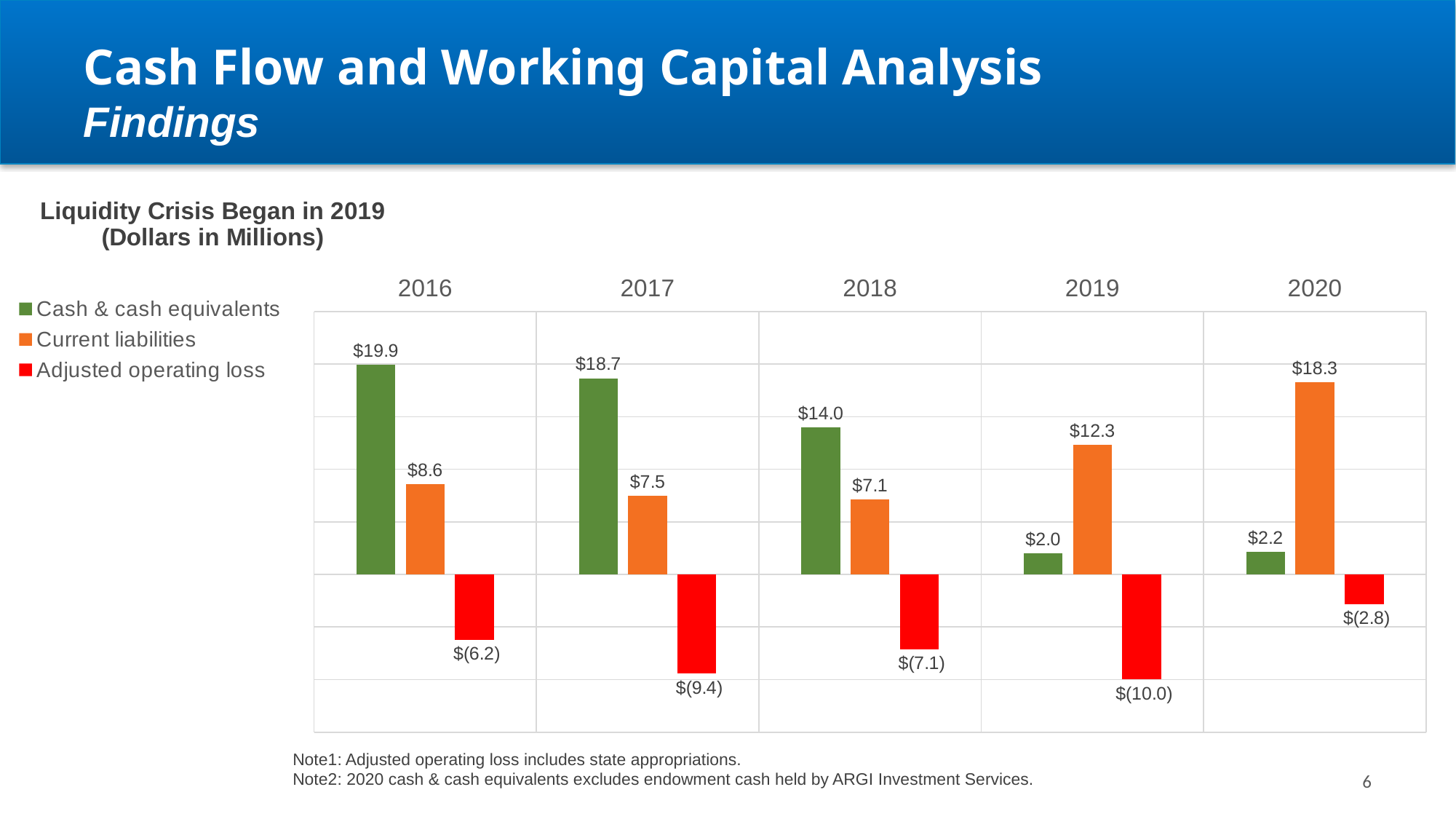
Which year has the lowest Cash & cash equivalents? 2019 How many series does the legend list? 3 Does Cash & cash equivalents rise or fall from 2016 to 2019? Fall What colour represents Adjusted operating loss in the chart? Red What is the value of Current liabilities in 2020? $18.3 What is the Adjusted operating loss in 2019? $(10.0) How many years are shown on the chart? 5 In 2019, which is larger: Cash & cash equivalents or Current liabilities? Current liabilities What is the difference between Cash & cash equivalents and Current liabilities in 2018? $6.9 Which year has the highest Current liabilities? 2020 What is the value of Cash & cash equivalents in 2016? $19.9 What kind of chart is shown on the slide? Bar chart